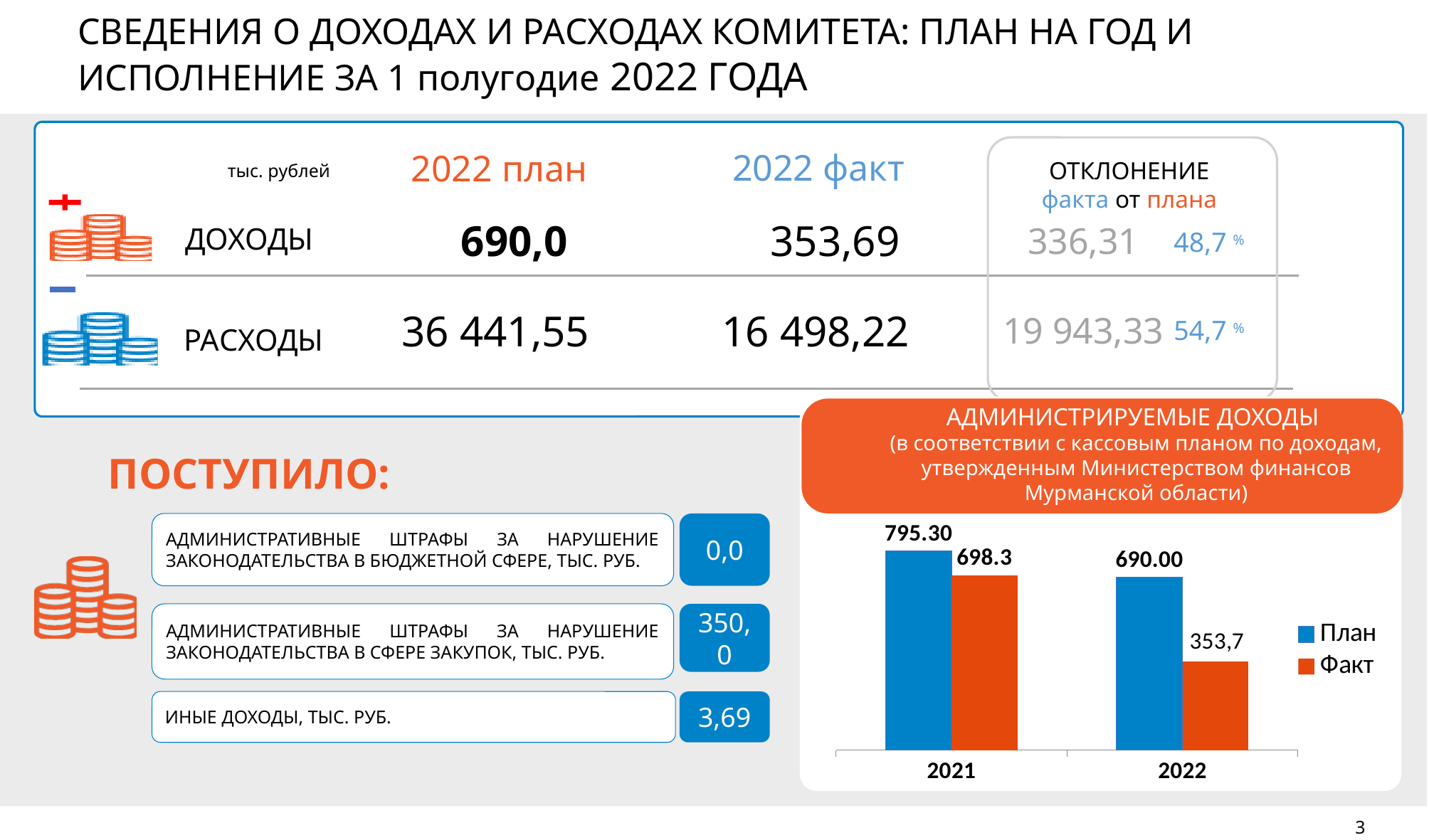
In the 'АДМИНИСТРИРУЕМЫЕ ДОХОДЫ' chart, which year has the highest Факт value? 2021 In the 'АДМИНИСТРИРУЕМЫЕ ДОХОДЫ' chart, what is the value of Факт for 2022? 353,7 In the 'АДМИНИСТРИРУЕМЫЕ ДОХОДЫ' chart, which is larger: План for 2021 or План for 2022? План for 2021 In the 'АДМИНИСТРИРУЕМЫЕ ДОХОДЫ' chart, what is the difference between План and Факт for 2022? 336.3 In the 'АДМИНИСТРИРУЕМЫЕ ДОХОДЫ' chart, what is the value of План for 2021? 795.30 In the 'АДМИНИСТРИРУЕМЫЕ ДОХОДЫ' chart, what is the value of Факт for 2021? 698.3 What type of chart is shown under the heading 'АДМИНИСТРИРУЕМЫЕ ДОХОДЫ'? bar chart In the 'АДМИНИСТРИРУЕМЫЕ ДОХОДЫ' chart, what is the value of План for 2022? 690.00 In the 'АДМИНИСТРИРУЕМЫЕ ДОХОДЫ' chart, does the Факт value rise or fall from 2021 to 2022? fall In the 'АДМИНИСТРИРУЕМЫЕ ДОХОДЫ' chart, what is the difference between План and Факт for 2021? 97.0 In the 'АДМИНИСТРИРУЕМЫЕ ДОХОДЫ' chart, which bar is the lowest overall? Факт 2022 How many series does the legend of the 'АДМИНИСТРИРУЕМЫЕ ДОХОДЫ' chart list? 2